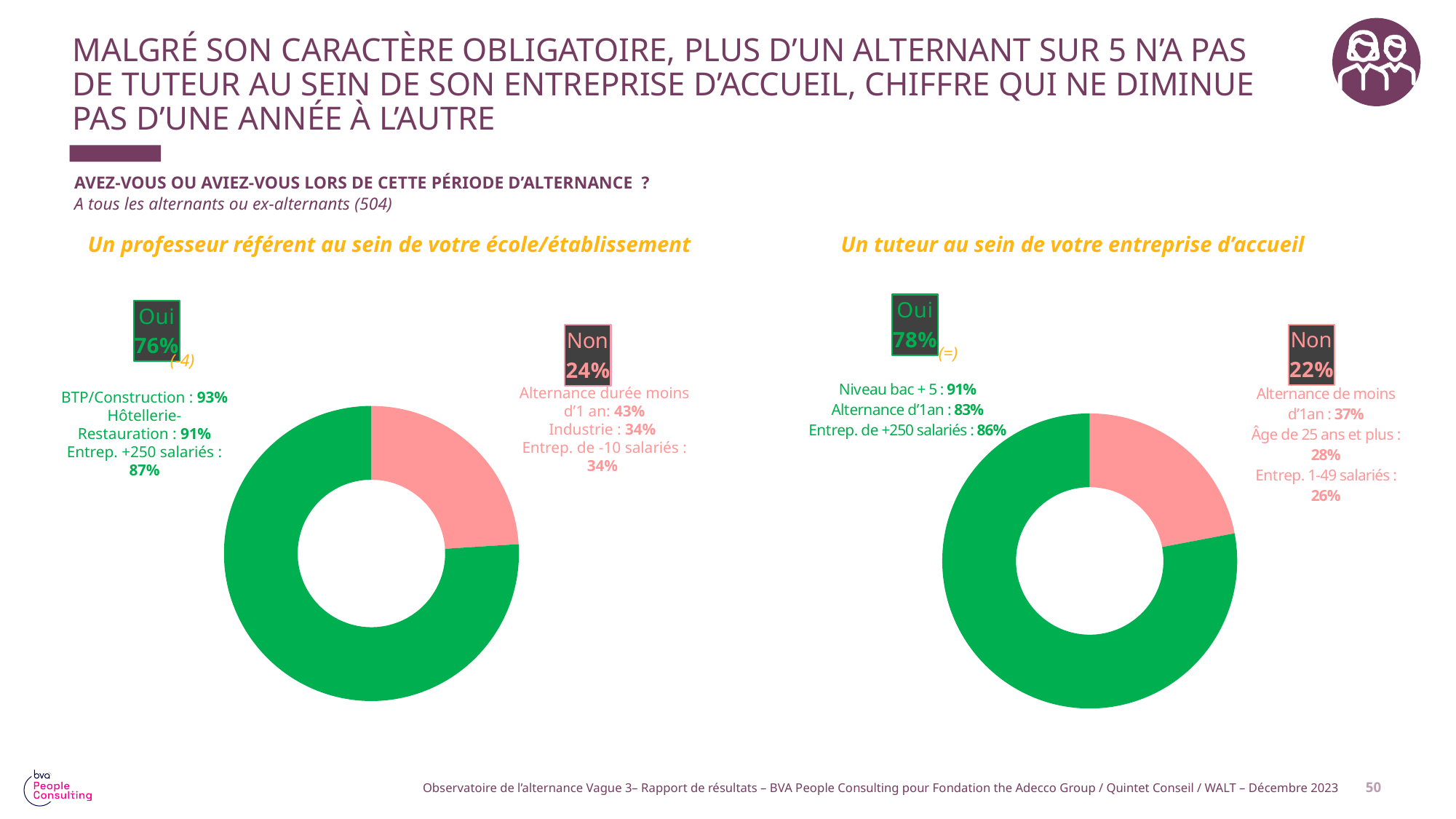
In the chart titled "Un professeur référent au sein de votre école/établissement", what share of respondents answered "Non"? 24% In the chart titled "Un tuteur au sein de votre entreprise d'accueil", which answer has the larger share, "Oui" or "Non"? Oui In the chart titled "Un professeur référent au sein de votre école/établissement", what share of respondents answered "Oui"? 76% In the chart titled "Un professeur référent au sein de votre école/établissement", what colour is the "Non" slice? Pink In the chart titled "Un professeur référent au sein de votre école/établissement", what is the difference in percentage points between "Oui" and "Non"? 52 percentage points What kind of chart is used on the left side of the slide, under "Un professeur référent au sein de votre école/établissement"? Donut (pie) chart In the chart titled "Un professeur référent au sein de votre école/établissement", which answer has the smallest share? Non In the chart titled "Un tuteur au sein de votre entreprise d'accueil", what share of respondents answered "Oui"? 78% Comparing the two charts, which has the higher "Non" share: "Un professeur référent au sein de votre école/établissement" or "Un tuteur au sein de votre entreprise d'accueil"? Un professeur référent au sein de votre école/établissement In the chart titled "Un tuteur au sein de votre entreprise d'accueil", what is the difference in percentage points between "Oui" and "Non"? 56 percentage points In the chart titled "Un tuteur au sein de votre entreprise d'accueil", what share of respondents answered "Non"? 22% How many slices does the chart titled "Un tuteur au sein de votre entreprise d'accueil" have? 2